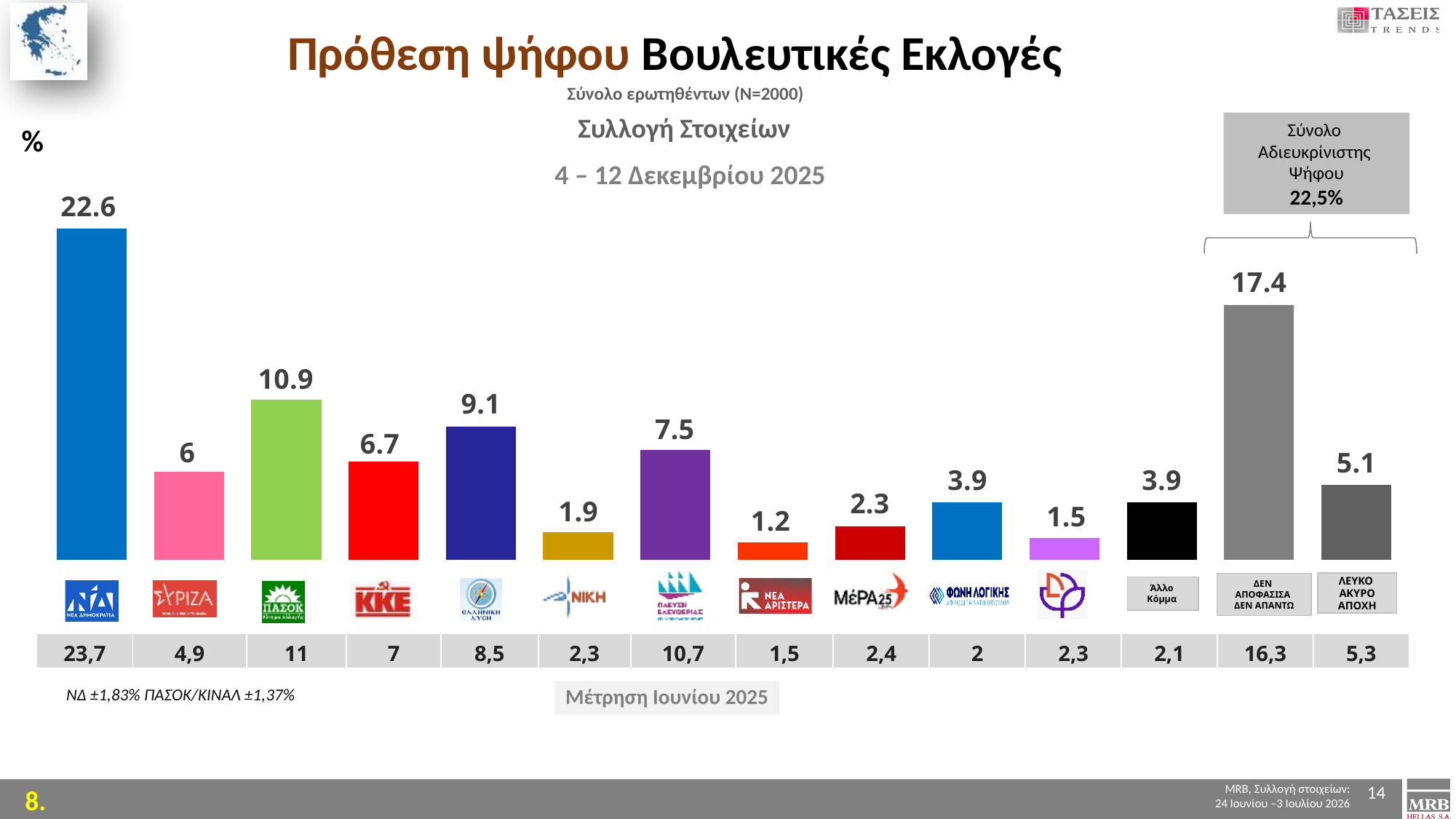
Which party has the highest vote intention value? ΝΔ (Νέα Δημοκρατία) What is the vote intention value shown for ΝΔ (Νέα Δημοκρατία)? 22.6 What is the value shown for ΔΕΝ ΑΠΟΦΑΣΙΣΑ / ΔΕΝ ΑΠΑΝΤΩ? 17.4 What is the value shown for ΚΚΕ? 6.7 What kind of chart is shown on the slide? Bar chart Which has a higher value, ΣΥΡΙΖΑ or ΚΚΕ? ΚΚΕ Which party has the lowest vote intention value? Νέα Αριστερά What is the difference between the values for ΝΔ and ΠΑΣΟΚ? 11.7 How many bars are shown in the chart? 14 What was the value for ΝΔ in the June 2025 measurement (Μέτρηση Ιουνίου 2025) row? 23,7 What is the value shown for ΠΑΣΟΚ? 10.9 What is the difference between the values for Ελληνική Λύση and Πλεύση Ελευθερίας? 1.6